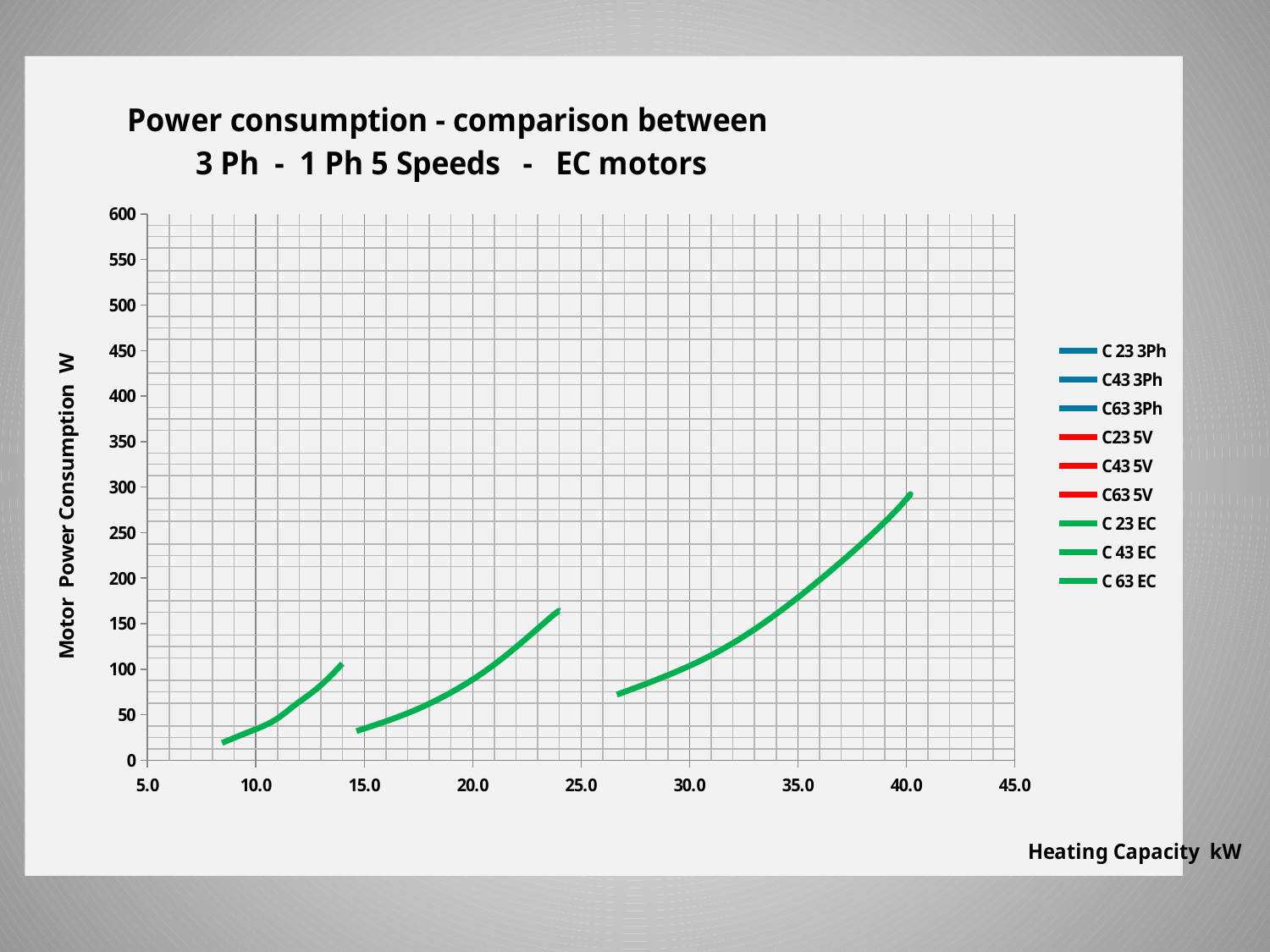
What is the title of the chart? Power consumption - comparison between 3 Ph - 1 Ph 5 Speeds - EC motors Is the highest value reached by the C 23 EC curve greater or less than 150? less Do the plotted curves rise or fall as heating capacity increases? rise Is the highest value reached by the C 63 EC curve greater or less than 250? greater How many series does the legend list? 9 How many curves are actually plotted on the chart? 3 Is the highest value reached by the C 43 EC curve greater or less than 200? less What kind of chart is shown on the slide? line chart Which plotted curve reaches the highest motor power consumption? C 63 EC Which plotted curve stays at the lowest motor power consumption? C 23 EC What colour are the EC motor series in the legend? green Which curve reaches a higher motor power consumption, C 43 EC or C 63 EC? C 63 EC